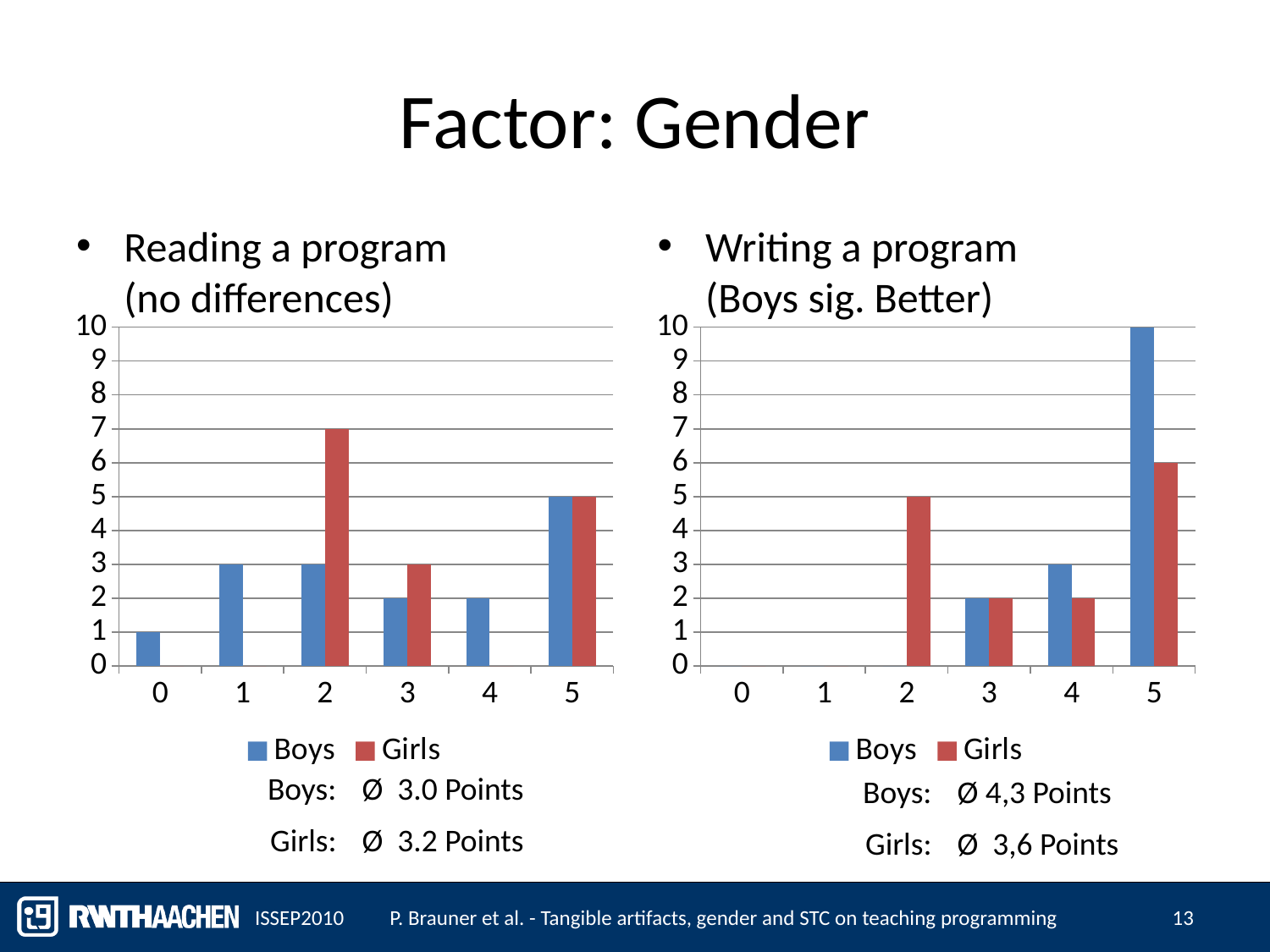
In the left chart (Reading a program), what is the value for Boys at score 0? 1 What kind of chart is the left chart (Reading a program)? Bar chart In the right chart (Writing a program), what is the difference between Boys and Girls at score 5? 4 In the right chart (Writing a program), which score has the highest Boys bar? 5 How many score categories are shown on the x axis of the right chart (Writing a program)? 6 In the right chart (Writing a program), is the value for Boys at score 5 greater or less than 8? greater In the left chart (Reading a program), what is the value for Girls at score 2? 7 In the right chart (Writing a program), what is the value for Girls at score 2? 5 How many series does the legend of the left chart (Reading a program) list? 2 In the left chart (Reading a program), which score has the highest Girls bar? 2 In the right chart (Writing a program), what is the value for Boys at score 5? 10 In the left chart (Reading a program), which is larger at score 2, Boys or Girls? Girls